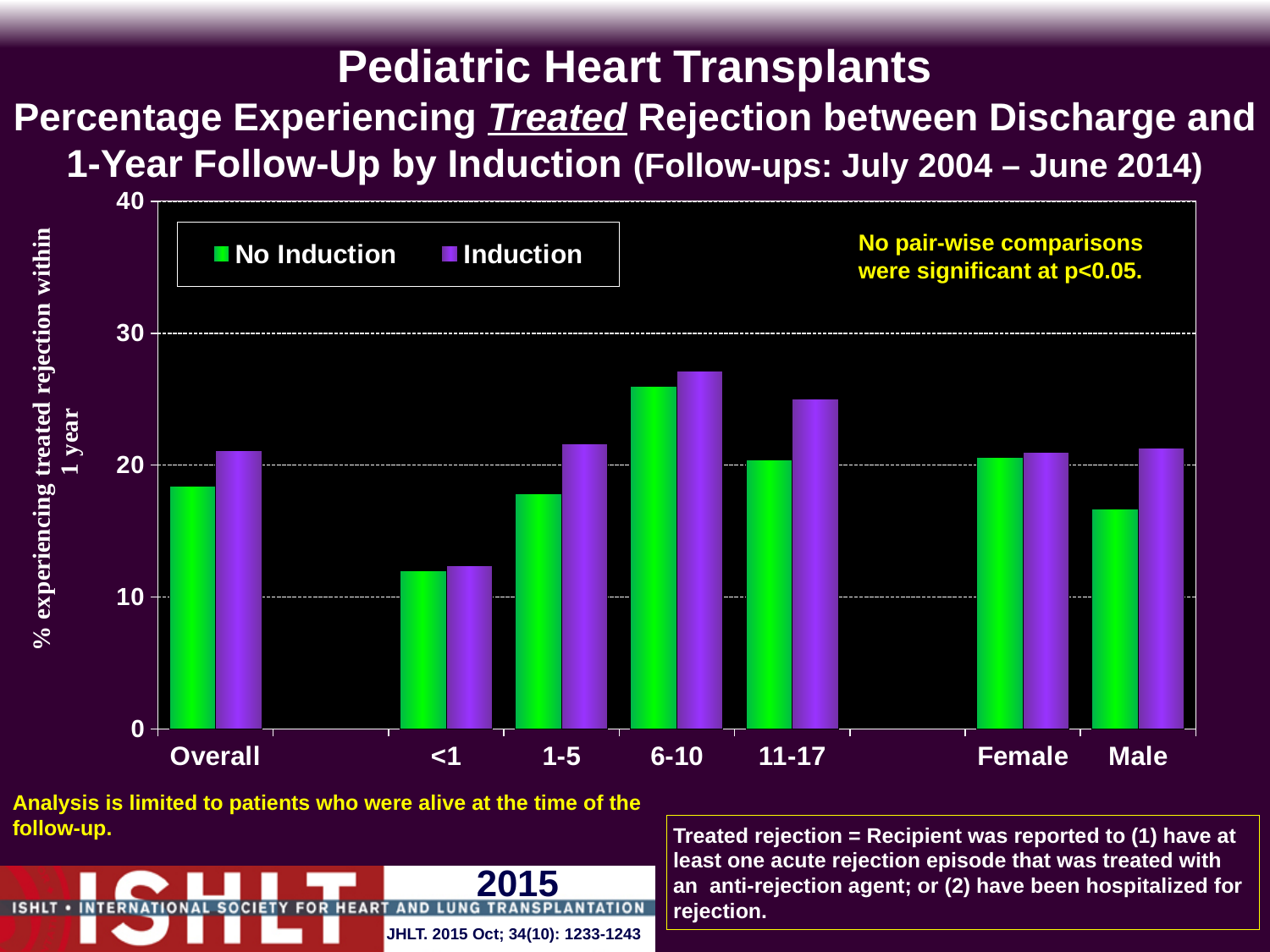
Which series is shown in green in the legend? No Induction Is the Induction value for 6-10 greater or less than 30? less Which category has the highest value for the No Induction series? 6-10 Is the Induction value for 11-17 greater or less than 20? greater Is the No Induction value for Overall greater or less than 20? less How many categories are shown along the x axis? 7 Which category has the highest value for the Induction series? 6-10 Which category has the lowest value for the Induction series? <1 How many series does the legend list? 2 For the 11-17 category, which series has the larger value, No Induction or Induction? Induction What kind of chart is shown on the slide? bar chart